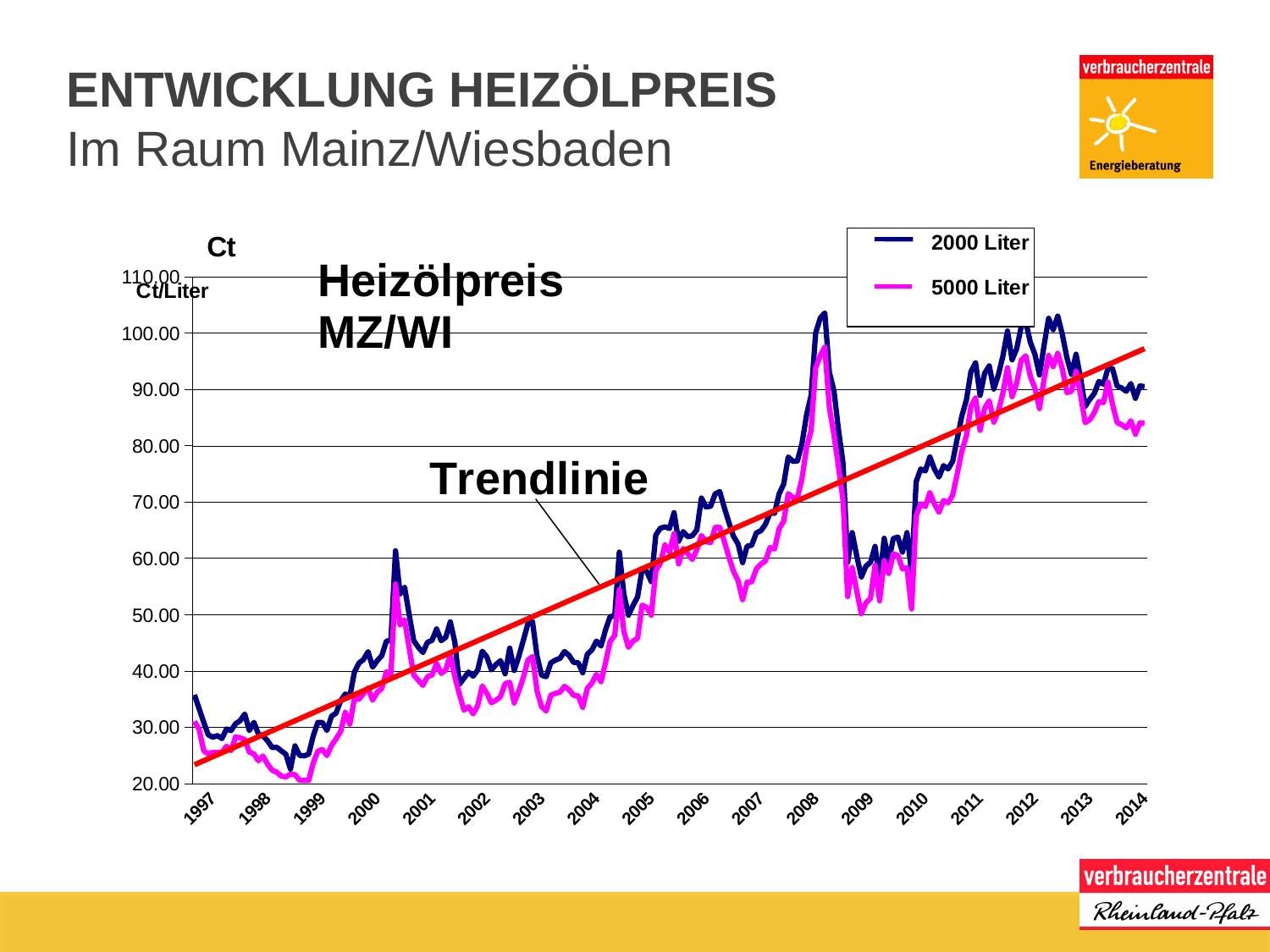
Is the value of the 2000 Liter series at the start of the chart in 1997 greater or less than 30? greater What is the title printed inside the chart area? Heizölpreis MZ/WI What kind of chart is shown on the slide? Line chart Is the value of the 5000 Liter series at the end of the chart in 2014 greater or less than 90? less Do the heating oil prices generally rise or fall from 1997 to 2014? Rise Is the peak value of the 2000 Liter series around 2008 greater or less than 90? greater Which series is generally higher, 2000 Liter or 5000 Liter? 2000 Liter In which year does the 2000 Liter series reach its highest peak before 2010? 2008 What are the two series named in the legend? 2000 Liter and 5000 Liter How many year labels are shown on the x axis? 18 How many series does the legend list? 2